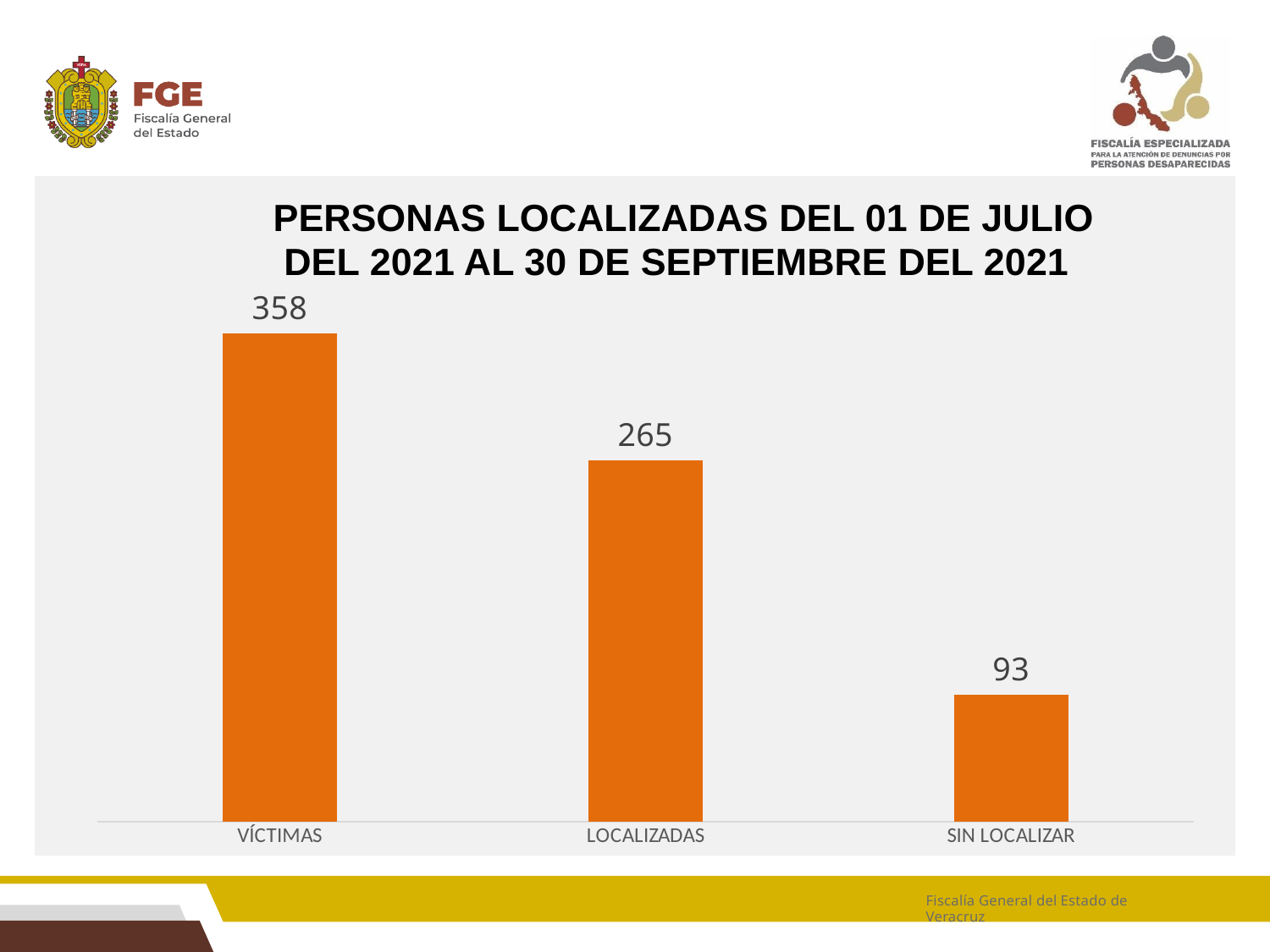
Do the values rise or fall from left to right across the categories? Fall What is the difference between the values for VÍCTIMAS and LOCALIZADAS? 93 Which is larger, the value for LOCALIZADAS or the value for SIN LOCALIZAR? LOCALIZADAS How many categories are shown in the chart? 3 Which category has the highest value? VÍCTIMAS What is the value for VÍCTIMAS? 358 What is the value for SIN LOCALIZAR? 93 What is the difference between the values for LOCALIZADAS and SIN LOCALIZAR? 172 Which category has the lowest value? SIN LOCALIZAR What is the title of the chart? PERSONAS LOCALIZADAS DEL 01 DE JULIO DEL 2021 AL 30 DE SEPTIEMBRE DEL 2021 What kind of chart is shown on the slide? Bar chart What is the value for LOCALIZADAS? 265